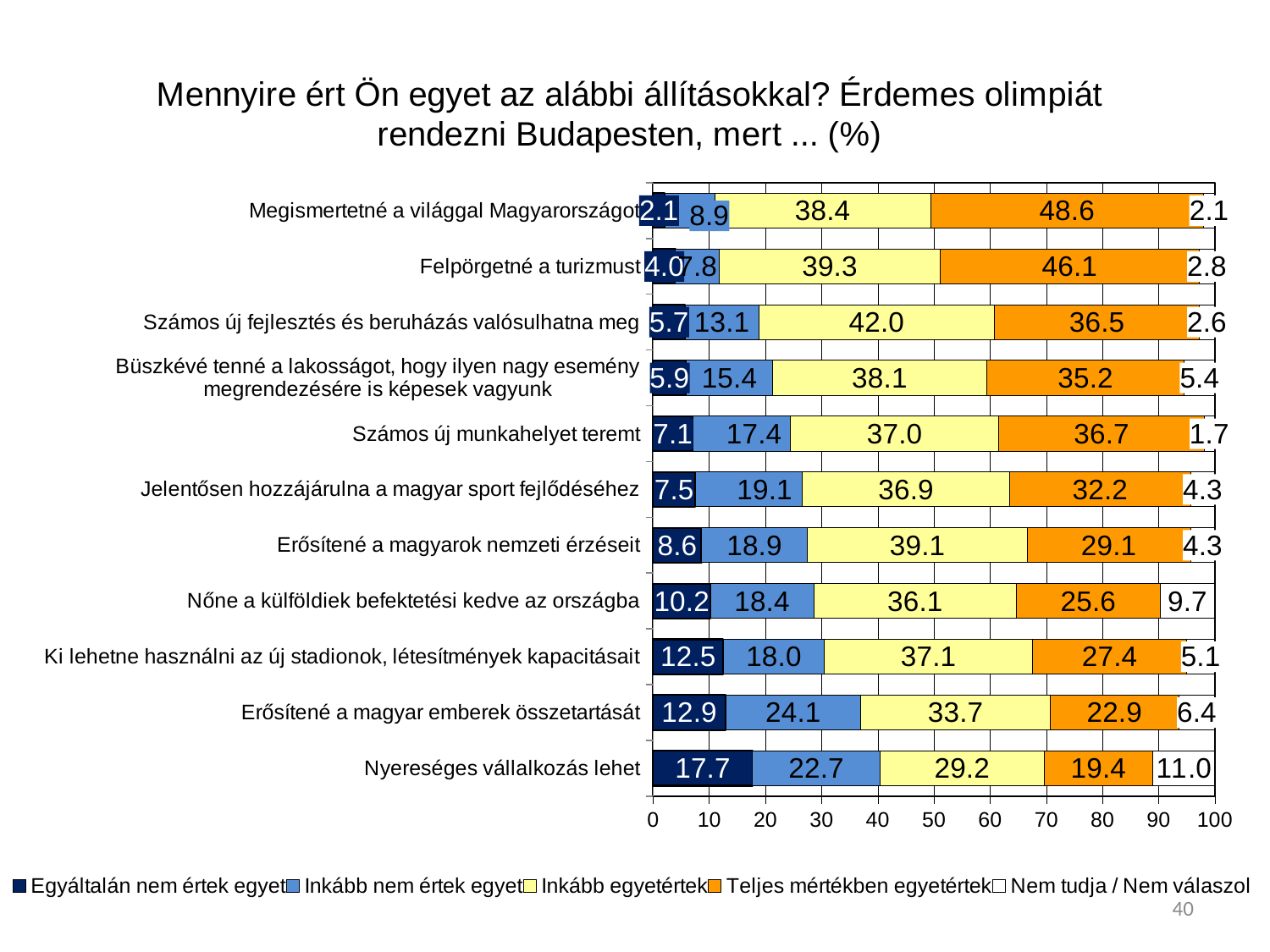
What is the 'Nem tudja / Nem válaszol' value for 'Nőne a külföldiek befektetési kedve az országba'? 9.7 What type of chart is shown on the slide? stacked bar chart What is the 'Inkább egyetértek' value for 'Számos új fejlesztés és beruházás valósulhatna meg'? 42.0 Which is larger: the 'Inkább nem értek egyet' value for 'Erősítené a magyar emberek összetartását' or for 'Felpörgetné a turizmust'? Erősítené a magyar emberek összetartását What is the total of the stacked bar for 'Nyereséges vállalkozás lehet'? 100.0 How many series does the legend list? 5 Which statement has the lowest 'Egyáltalán nem értek egyet' value? Megismertetné a világgal Magyarországot What is the 'Teljes mértékben egyetértek' value for 'Megismertetné a világgal Magyarországot'? 48.6 Which statement has the highest 'Teljes mértékben egyetértek' value? Megismertetné a világgal Magyarországot What is the 'Egyáltalán nem értek egyet' value for 'Nyereséges vállalkozás lehet'? 17.7 How many statements (categories) are plotted in the chart? 11 What is the difference between the 'Teljes mértékben egyetértek' values for 'Megismertetné a világgal Magyarországot' and 'Nyereséges vállalkozás lehet'? 29.2